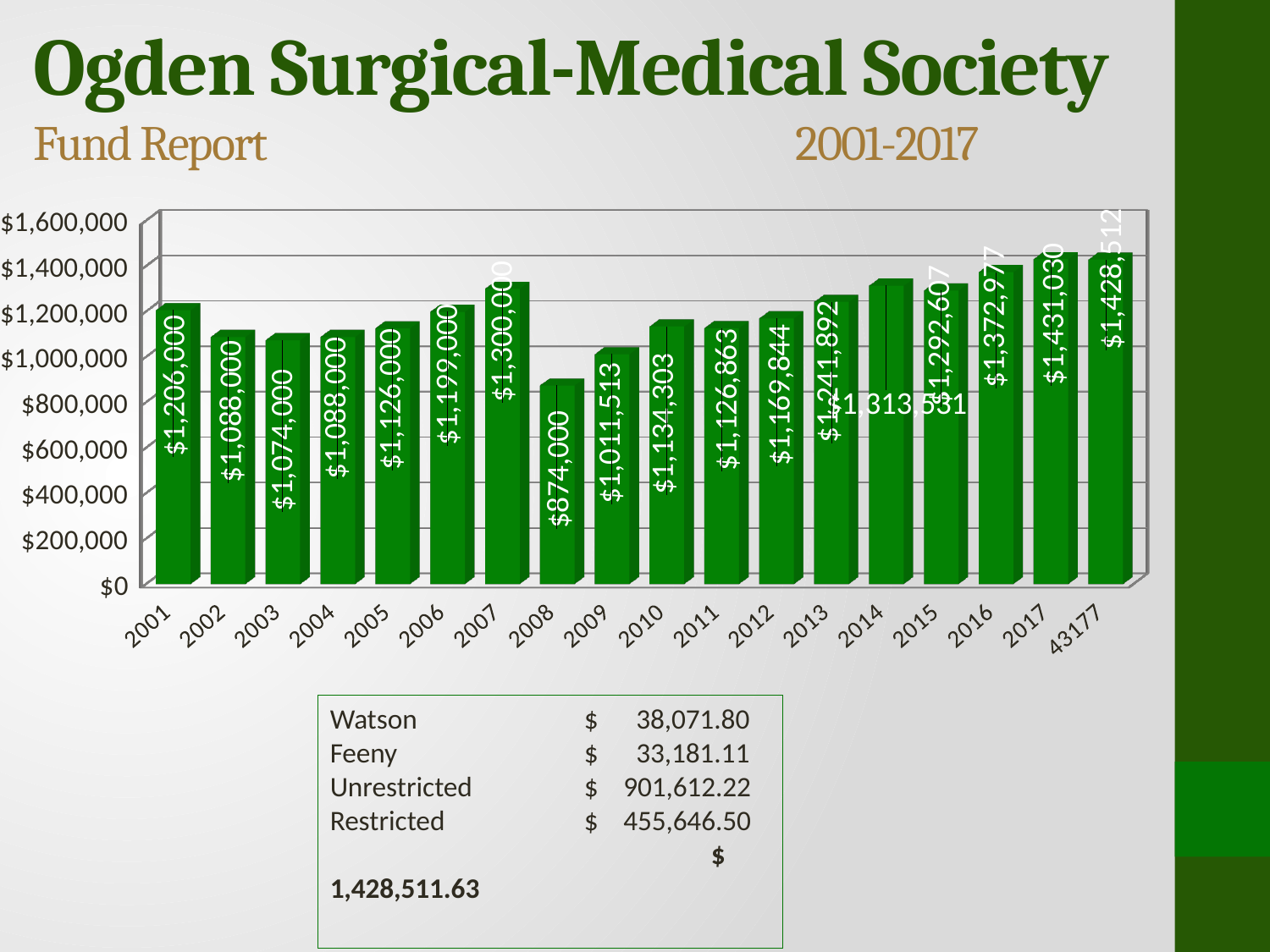
What is the value for 2017? $1,431,030 Which is larger, the value for 2001 or the value for 2003? 2001 What is the value for 2008? $874,000 Is the value for 2008 greater or less than $1,000,000? less What is the value for 2001? $1,206,000 What is the difference between the values for 2001 and 2002? $118,000 Which year has the lowest value? 2008 Do the values rise or fall from 2008 to 2013? rise What kind of chart is shown on the slide? bar chart How many bars are plotted in the chart? 18 What colour are the bars in the chart? green What is the value for 2013? $1,241,892